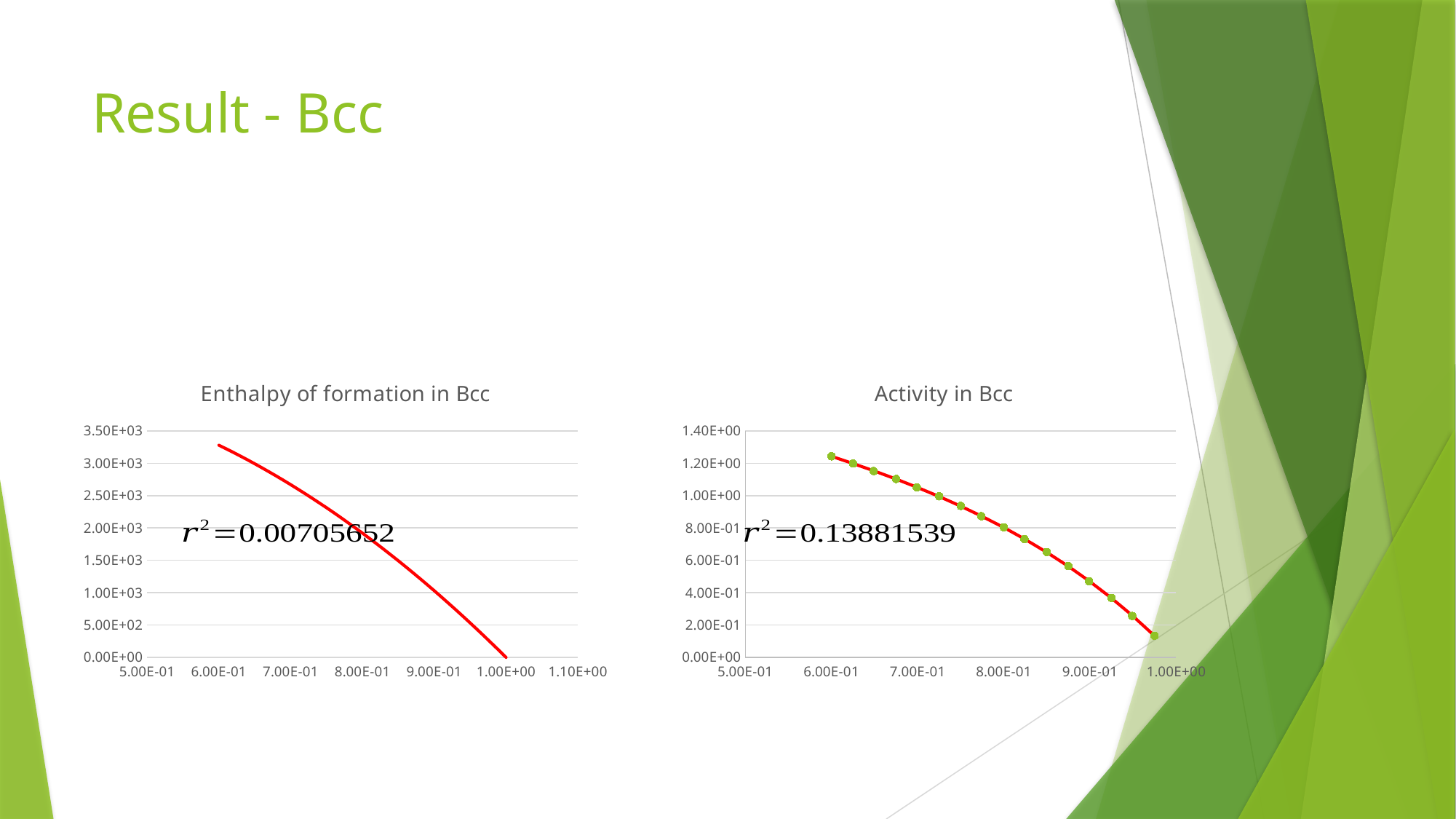
In the 'Enthalpy of formation in Bcc' chart, do the values rise or fall as the x-axis value increases? fall In the 'Enthalpy of formation in Bcc' chart, is the value at x = 6.00E-01 greater or less than 3.00E+03? greater In the 'Activity in Bcc' chart, is the value at x = 7.00E-01 greater or less than 1.00E+00? greater In the 'Enthalpy of formation in Bcc' chart, is the value at x = 1.00E+00 greater or less than 5.00E+02? less What is the title of the chart on the right side of the slide? Activity in Bcc In the 'Activity in Bcc' chart, do the values rise or fall as the x-axis value increases? fall What r² value is shown on the 'Enthalpy of formation in Bcc' chart? 0.00705652 What kind of chart is the 'Enthalpy of formation in Bcc' chart? line chart